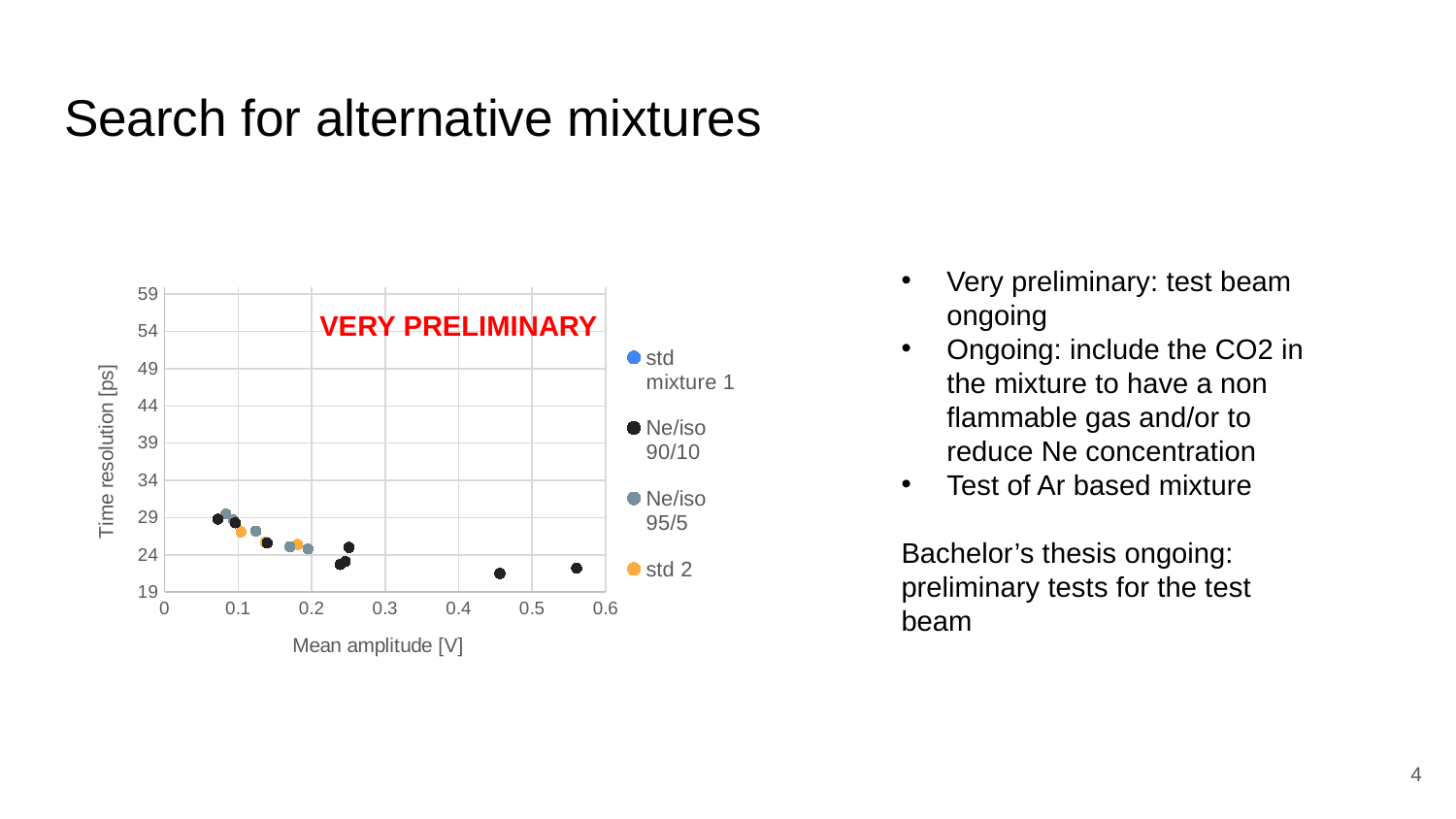
Which series in the legend is plotted in orange? std 2 How many series does the chart legend list? 4 Is the time resolution of the Ne/iso 90/10 point with the largest mean amplitude (near 0.56 V) greater or less than 24 ps? less Are all plotted time resolution values greater or less than 34 ps? less Is the time resolution of the Ne/iso 90/10 point near 0.45 V greater or less than 24 ps? less What is the label of the x axis of the chart? Mean amplitude [V] Do the time resolution values generally rise or fall as mean amplitude increases along the x axis? fall What is the label of the y axis of the chart? Time resolution [ps] What kind of chart is shown on the slide? scatter chart